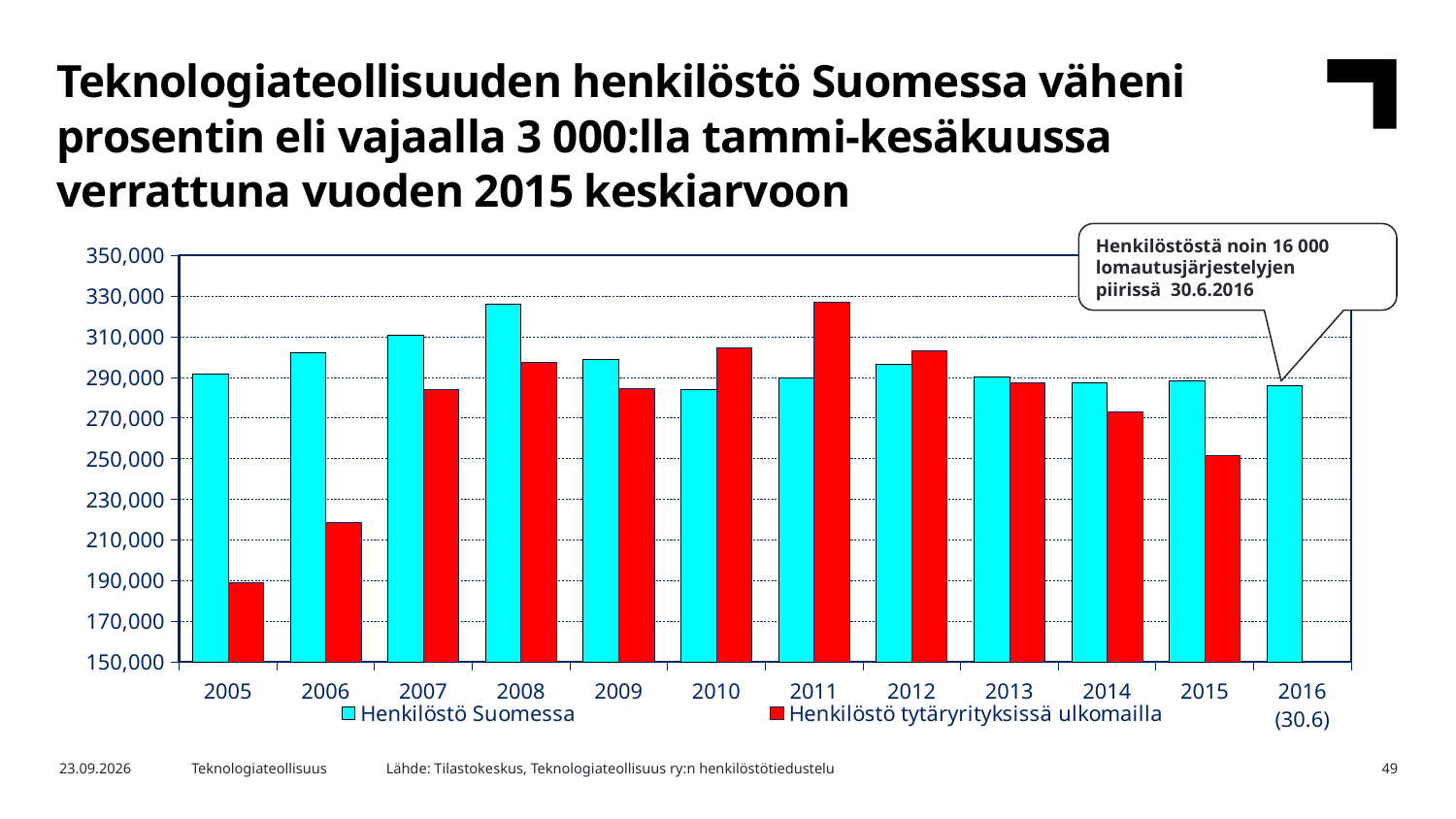
Is the value for Henkilöstö tytäryrityksissä ulkomailla in 2014 greater or less than 290,000? less How many series does the legend list? 2 Is the value for Henkilöstö Suomessa in 2008 greater or less than 310,000? greater How many years are shown on the x axis? 12 What kind of chart is shown on the slide? Bar chart In which year is Henkilöstö tytäryrityksissä ulkomailla highest? 2011 Does Henkilöstö tytäryrityksissä ulkomailla rise or fall from 2011 to 2015? Fall In 2015, which is larger: Henkilöstö Suomessa or Henkilöstö tytäryrityksissä ulkomailla? Henkilöstö Suomessa In 2011, which is larger: Henkilöstö Suomessa or Henkilöstö tytäryrityksissä ulkomailla? Henkilöstö tytäryrityksissä ulkomailla In which year is Henkilöstö tytäryrityksissä ulkomailla lowest? 2005 In which year is Henkilöstö Suomessa highest? 2008 Is the value for Henkilöstö tytäryrityksissä ulkomailla in 2005 greater or less than 210,000? less